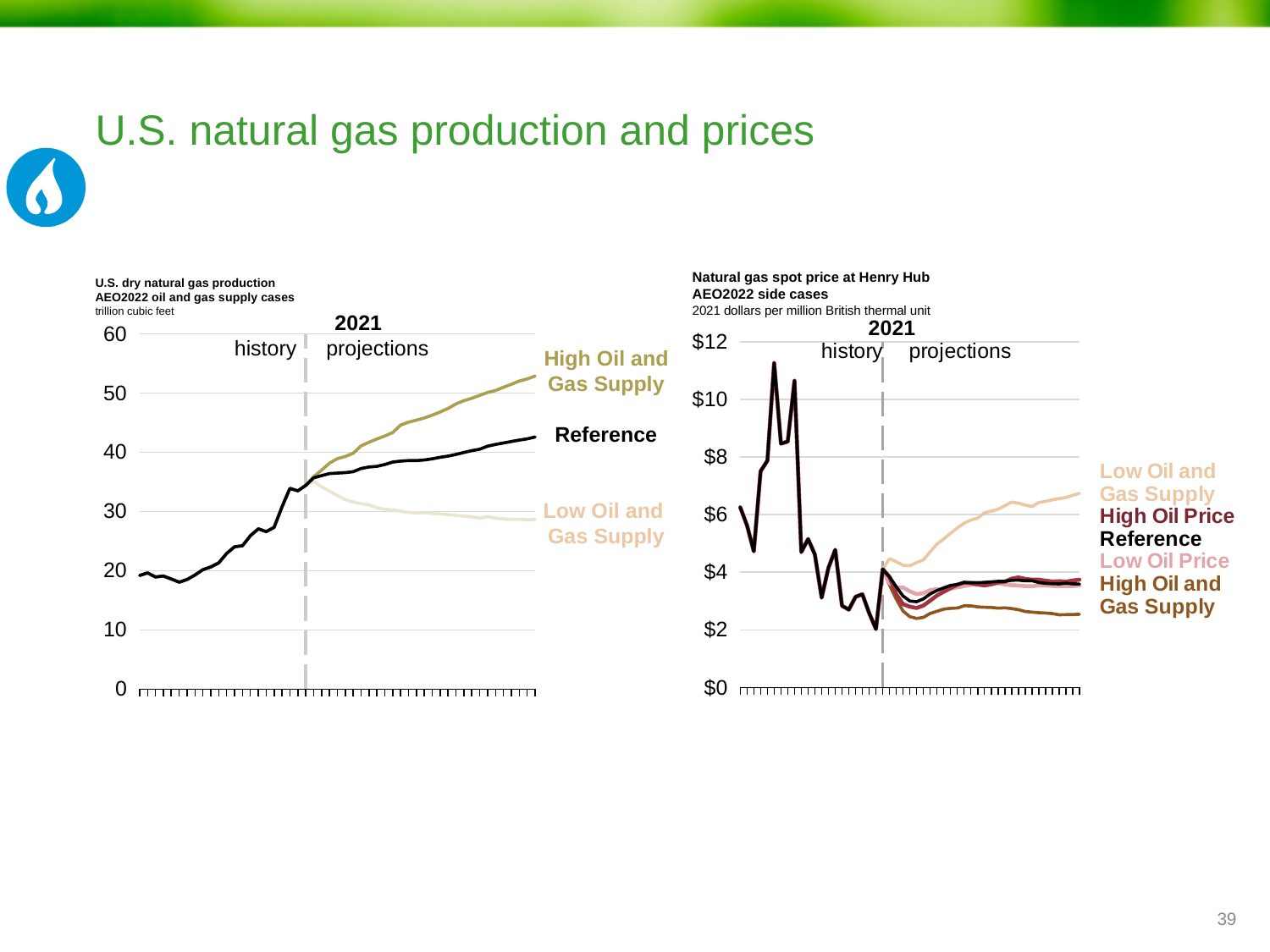
How many series are labelled on the left chart, 'U.S. dry natural gas production'? 3 What kind of chart is the right chart, 'Natural gas spot price at Henry Hub'? line chart In the left chart, 'U.S. dry natural gas production', is the final value of the High Oil and Gas Supply series greater or less than 50? greater What kind of chart is the left chart, 'U.S. dry natural gas production'? line chart In the left chart, 'U.S. dry natural gas production', which series is highest at the end of the projection period? High Oil and Gas Supply In the left chart, 'U.S. dry natural gas production', does the Reference series rise or fall over the projection period? rise In the left chart, 'U.S. dry natural gas production', which series is lowest at the end of the projection period? Low Oil and Gas Supply In the right chart, 'Natural gas spot price at Henry Hub', which series is highest at the end of the projection period? Low Oil and Gas Supply In the right chart, 'Natural gas spot price at Henry Hub', is the final value of the High Oil and Gas Supply series greater or less than $4? less How many series are labelled on the right chart, 'Natural gas spot price at Henry Hub'? 5 In the left chart, 'U.S. dry natural gas production', is the final value of the Low Oil and Gas Supply series greater or less than 30? less What unit is used on the y axis of the right chart, 'Natural gas spot price at Henry Hub'? 2021 dollars per million British thermal unit